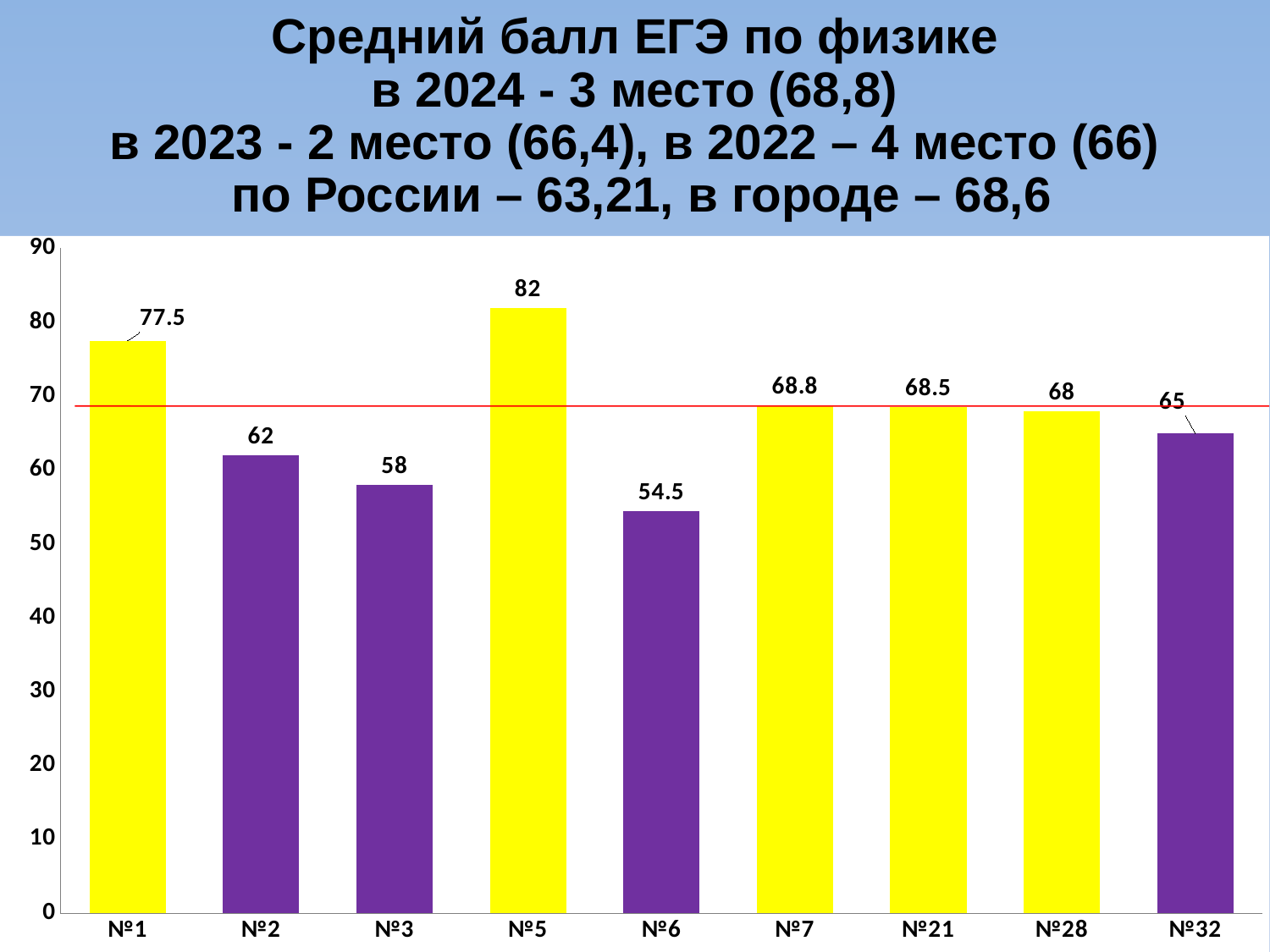
Which category has the highest value? №5 What is the difference between the values for №1 and №2? 15.5 What kind of chart is this? bar chart What is the value for №5? 82 Which is larger, the value for №3 or the value for №32? №32 What is the difference between the values for №7 and №28? 0.8 Which category has the lowest value? №6 How many categories are shown on the x axis? 9 What is the value for №21? 68.5 Is the value for №28 greater or less than 60? greater What is the value for №6? 54.5 How many bars are coloured yellow? 5